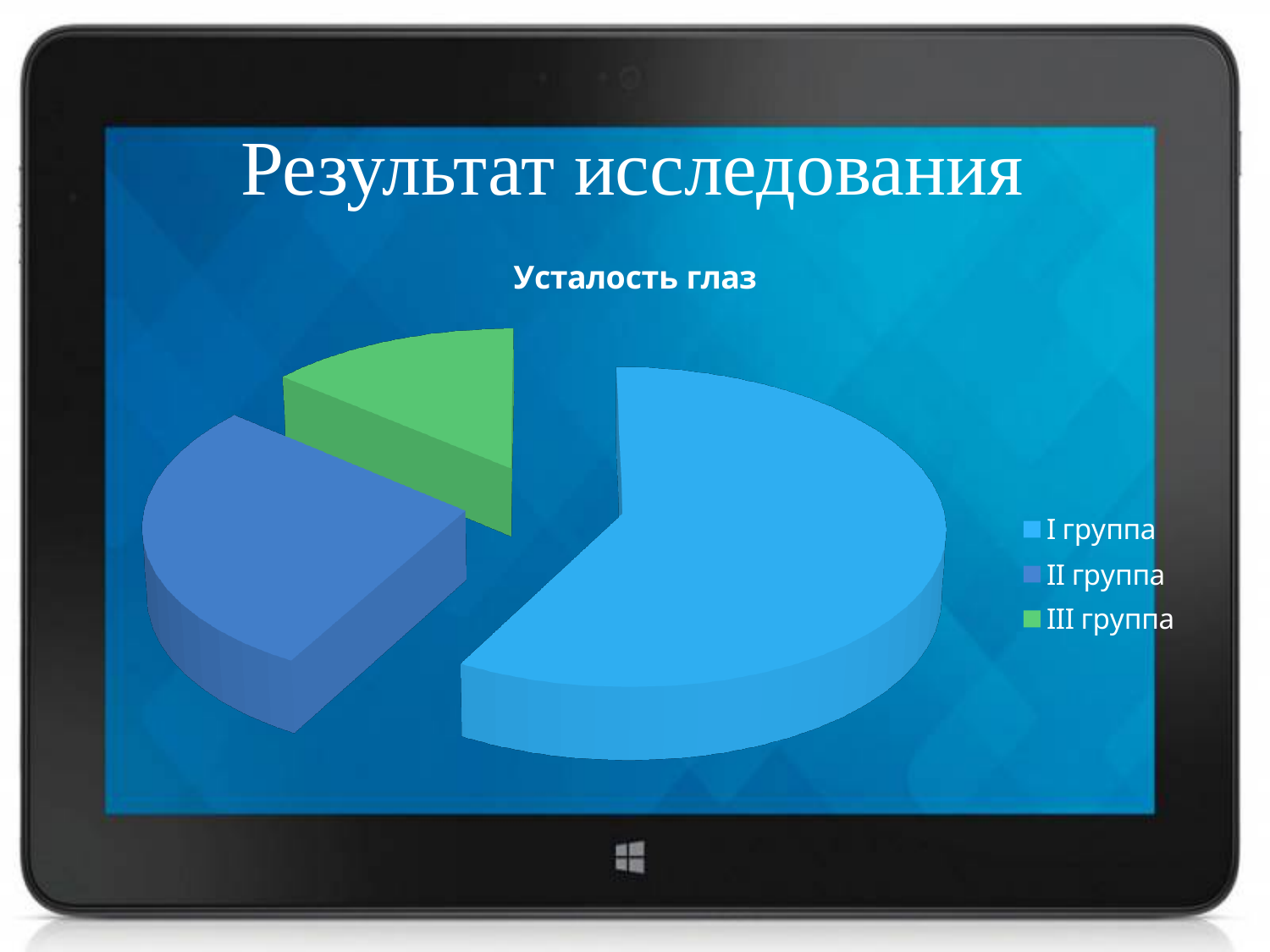
Which group has the smallest slice of the pie? III группа How many entries does the legend list? 3 Is the slice for III группа greater or less than a quarter of the pie? less What colour is the slice for III группа? green What is the title of the chart? Усталость глаз How many slices does the pie chart have? 3 What kind of chart is shown on the slide? pie chart Which slice is larger, I группа or II группа? I группа Which slice is larger, II группа or III группа? II группа Which group has the largest slice of the pie? I группа Which slice is smaller, I группа or III группа? III группа Is the slice for I группа greater or less than half of the pie? greater